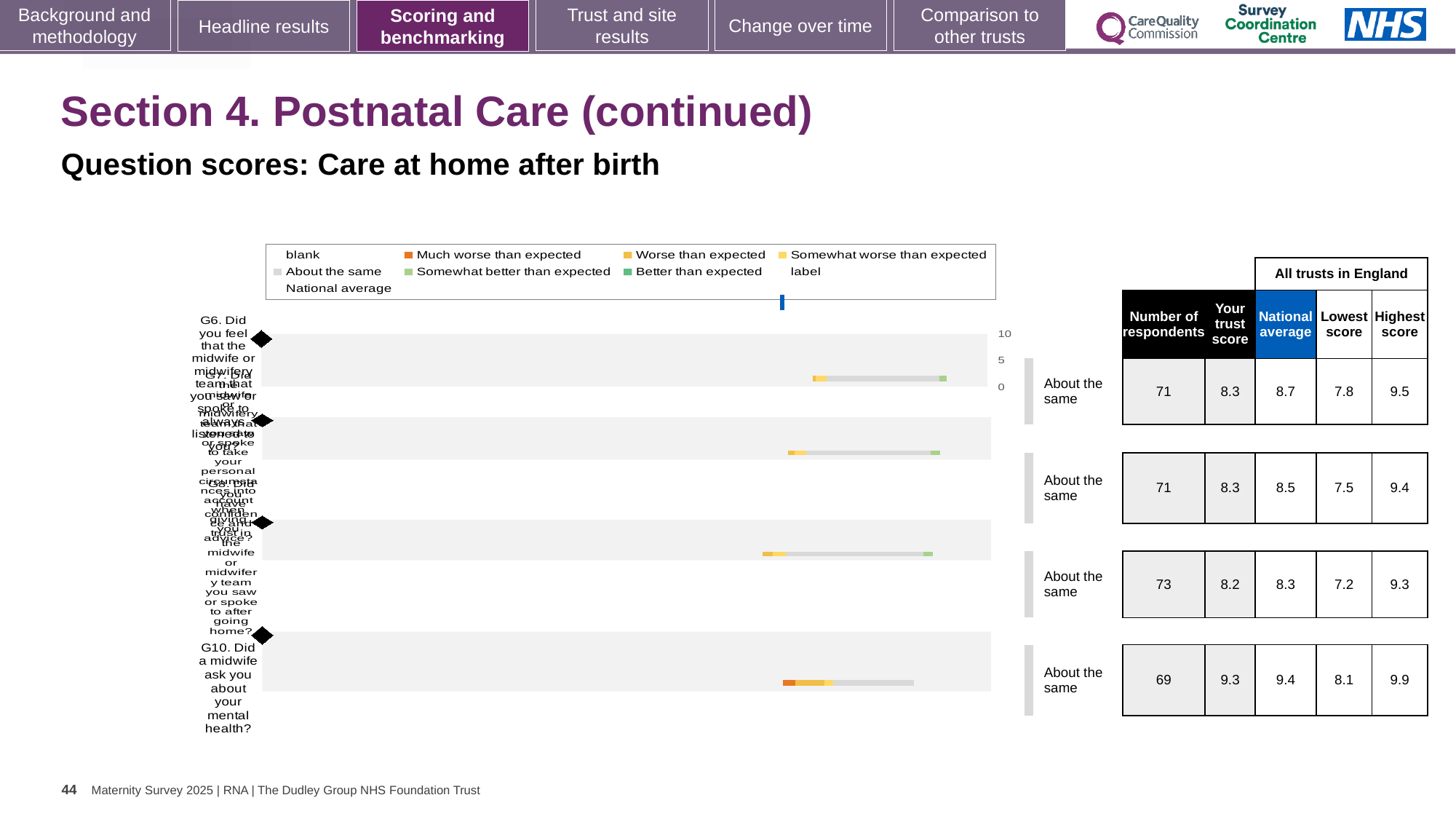
Which row has the highest 'Highest score' value in the table? G10. Did a midwife ask you about your mental health? How many survey questions are plotted as rows in the chart? 4 What is the benchmark category shown for every question on this slide? About the same What kind of chart is shown on the slide? bar chart What is the difference between the national average and the trust score for G10? 0.1 How many respondents answered G10 'Did a midwife ask you about your mental health?'? 69 Which is larger for G10, the trust score or the national average? National average Which legend entry is shown with an orange marker? Much worse than expected What is the title of the chart section shown on the slide? Question scores: Care at home after birth What is the national average for G10 'Did a midwife ask you about your mental health?'? 9.4 What is the highest score across all trusts in England for G10 'Did a midwife ask you about your mental health?'? 9.9 What is the trust score for G10 'Did a midwife ask you about your mental health?'? 9.3